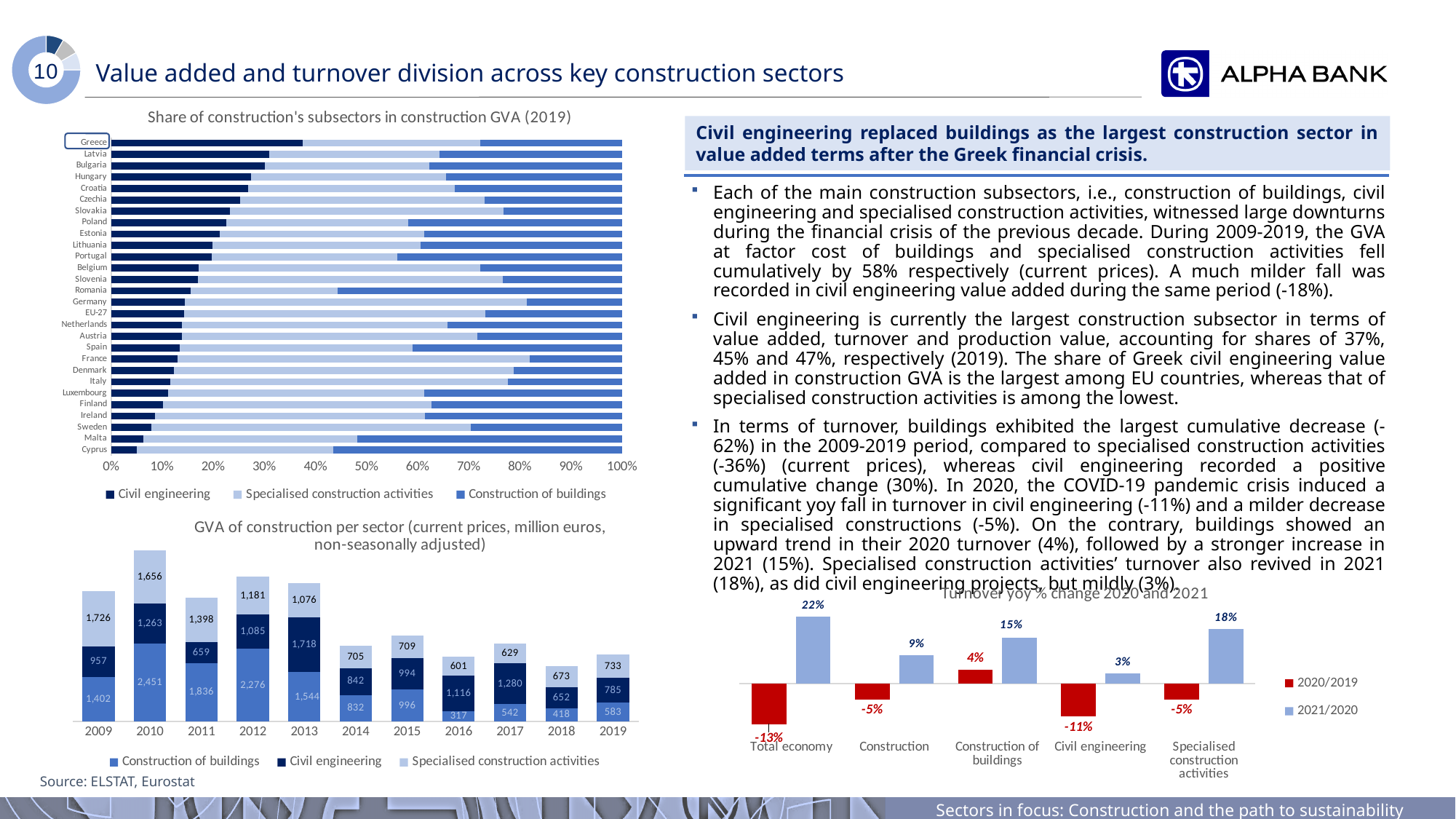
In the 'Share of construction's subsectors in construction GVA (2019)' chart, is the Civil engineering share for Greece greater or less than 30%? greater In the 'GVA of construction per sector' chart, what is the total of the stacked bar for 2019? 2,101 In the 'GVA of construction per sector' chart, what is the value for Civil engineering in 2019? 785 In the 'GVA of construction per sector' chart, which year has the lowest value for Construction of buildings? 2016 In the 'GVA of construction per sector' chart, what is the value for Construction of buildings in 2010? 2,451 In the 'Turnover yoy % change 2020 and 2021' chart, what is the 2020/2019 value for Civil engineering? -11% In the 'Turnover yoy % change 2020 and 2021' chart, how many series does the legend list? 2 In the 'GVA of construction per sector' chart, what is the difference between Civil engineering in 2013 and Civil engineering in 2014? 876 In the 'GVA of construction per sector' chart, how many years are shown on the x axis? 11 In the 'Turnover yoy % change 2020 and 2021' chart, which category has the highest 2021/2020 value? Total economy What kind of chart is the 'Share of construction's subsectors in construction GVA (2019)' chart? Stacked bar chart In the 'Turnover yoy % change 2020 and 2021' chart, what is the 2021/2020 value for Total economy? 22%